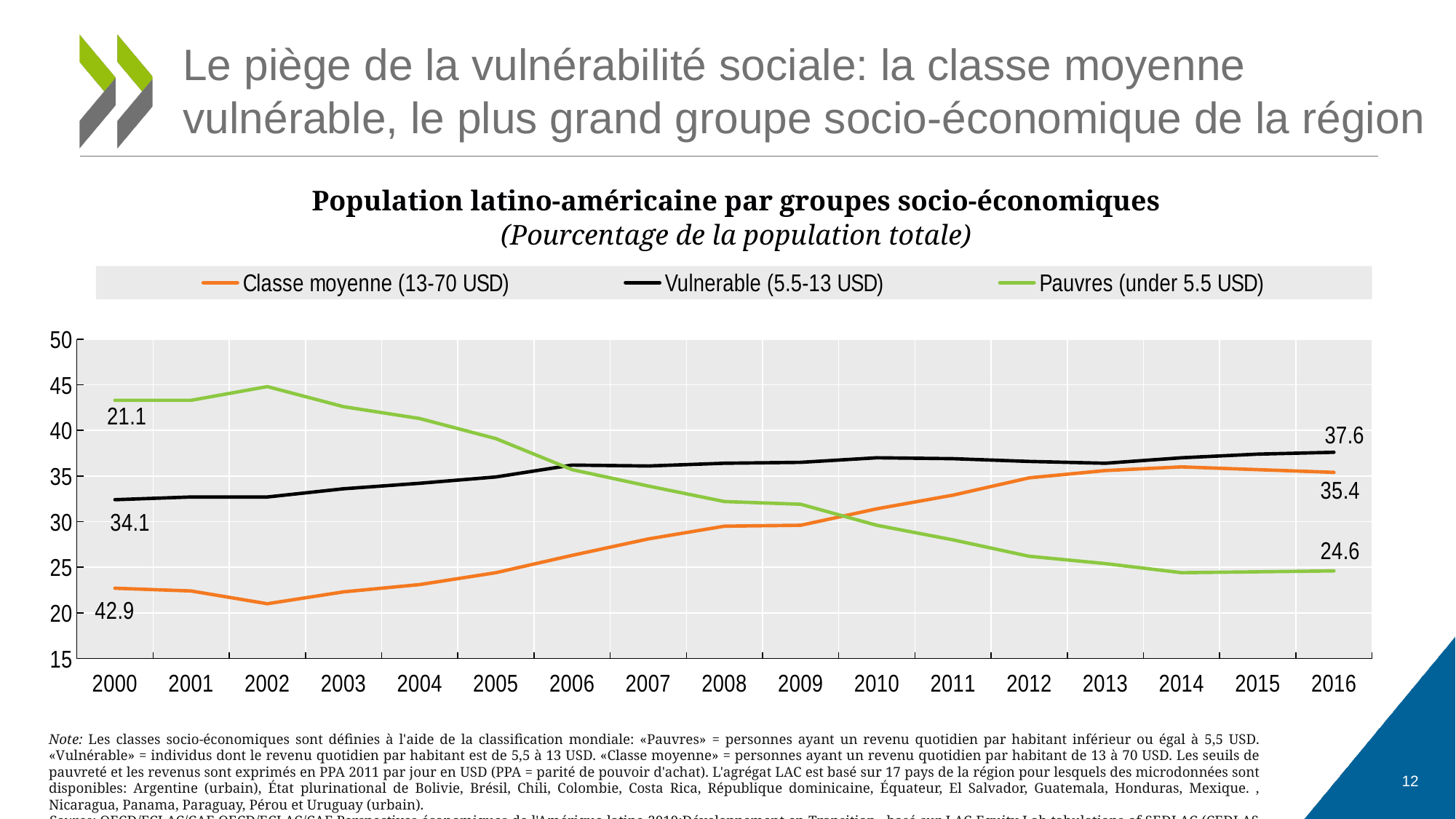
What is the value for Classe moyenne (13-70 USD) in 2016? 35.4 How many series does the legend list? 3 What is the difference between the Vulnerable and Classe moyenne values in 2016? 2.2 How many years are shown on the x axis? 17 What kind of chart is shown on the slide? line chart Which group has the lowest value in 2016? Pauvres (under 5.5 USD) What is the value for Pauvres (under 5.5 USD) in 2016? 24.6 Is the value for Pauvres (under 5.5 USD) in 2000 greater or less than 40? greater What is the value for Vulnerable (5.5-13 USD) in 2016? 37.6 What is the difference between the Classe moyenne and Pauvres values in 2016? 10.8 Does the Pauvres (under 5.5 USD) line rise or fall from 2002 to 2016? fall Which group has the highest value in 2016? Vulnerable (5.5-13 USD)